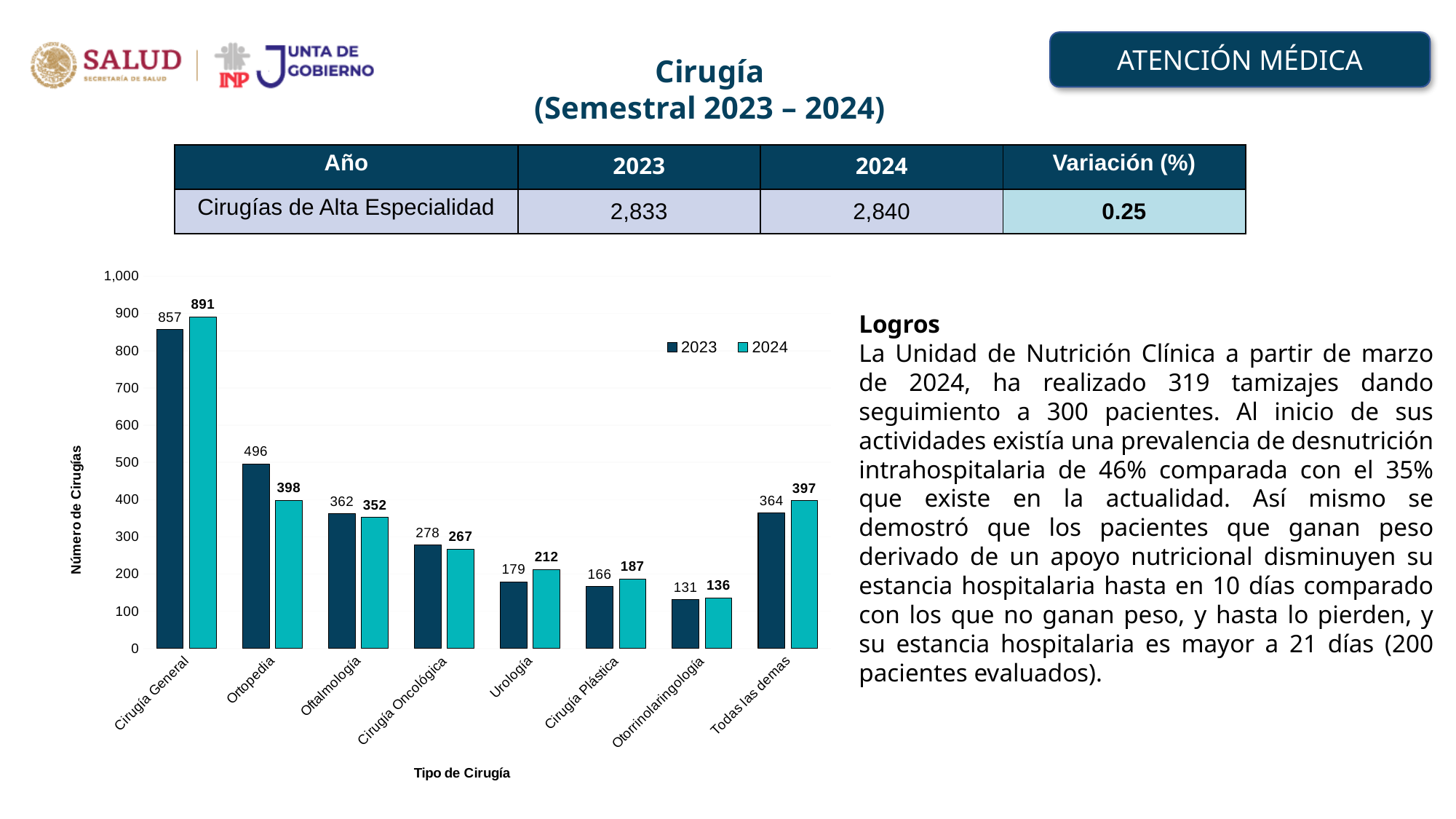
What kind of chart is shown on the slide? bar chart What is the 2023 value for Ortopedia? 496 Which type of surgery has the lowest 2024 value? Otorrinolaringología How many series does the legend list? 2 What is the 2024 value for Cirugía General? 891 What is the difference between the 2024 and 2023 values for Ortopedia? 98 Which is larger for Oftalmología, the 2023 value or the 2024 value? 2023 Which type of surgery has the highest 2023 value? Cirugía General What is the 2024 value for Otorrinolaringología? 136 Is the 2023 value for Urología greater or less than 200? less How many types of surgery are shown on the x axis? 8 What is the label of the y axis? Número de Cirugías